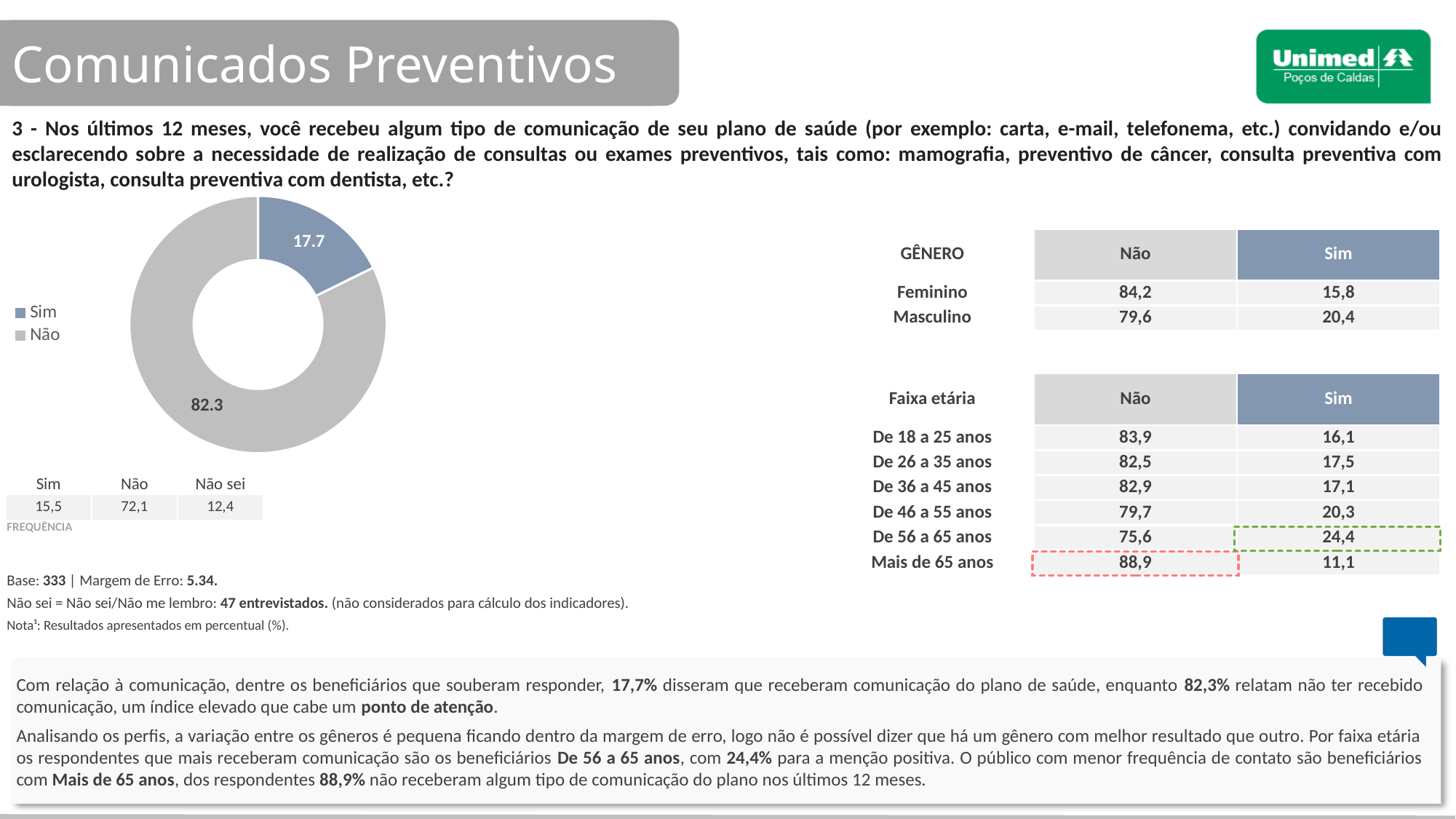
Which slice of the donut chart is the largest? Não How many slices does the donut chart have? 2 What are the legend entries of the donut chart? Sim, Não In the donut chart, which is larger: Sim or Não? Não What type of chart is shown on the slide? Pie chart (donut) What is the value of the Sim slice in the donut chart? 17.7 How many entries does the legend of the donut chart list? 2 What is the value of the Não slice in the donut chart? 82.3 What colour is the Sim slice in the donut chart? Blue What is the difference between the Não and Sim values in the donut chart? 64.6 Which slice of the donut chart is the smallest? Sim What share of the donut chart does the Não slice represent? 82.3